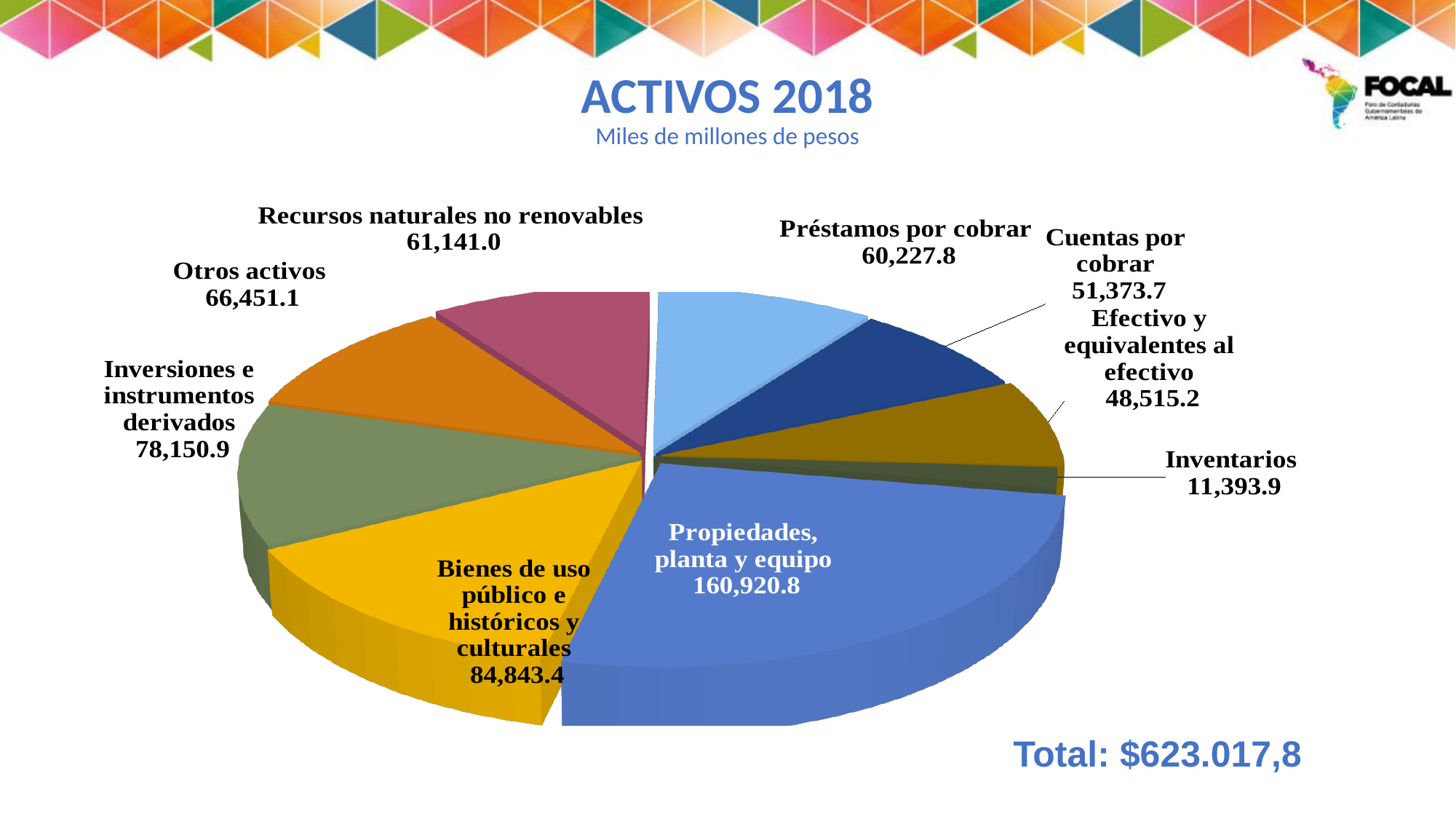
What is the difference between Propiedades, planta y equipo and Bienes de uso público e históricos y culturales? 76,077.4 What kind of chart is shown on the slide? Pie chart What is the difference between Inversiones e instrumentos derivados and Otros activos? 11,699.8 Which category has the smallest value? Inventarios What is the value for Inventarios? 11,393.9 Which is larger, Recursos naturales no renovables or Préstamos por cobrar? Recursos naturales no renovables What is the value for Propiedades, planta y equipo? 160,920.8 What is the value for Inversiones e instrumentos derivados? 78,150.9 What unit is stated under the chart title? Miles de millones de pesos What is the value for Efectivo y equivalentes al efectivo? 48,515.2 Which category has the largest value? Propiedades, planta y equipo How many categories does the pie chart show? 9